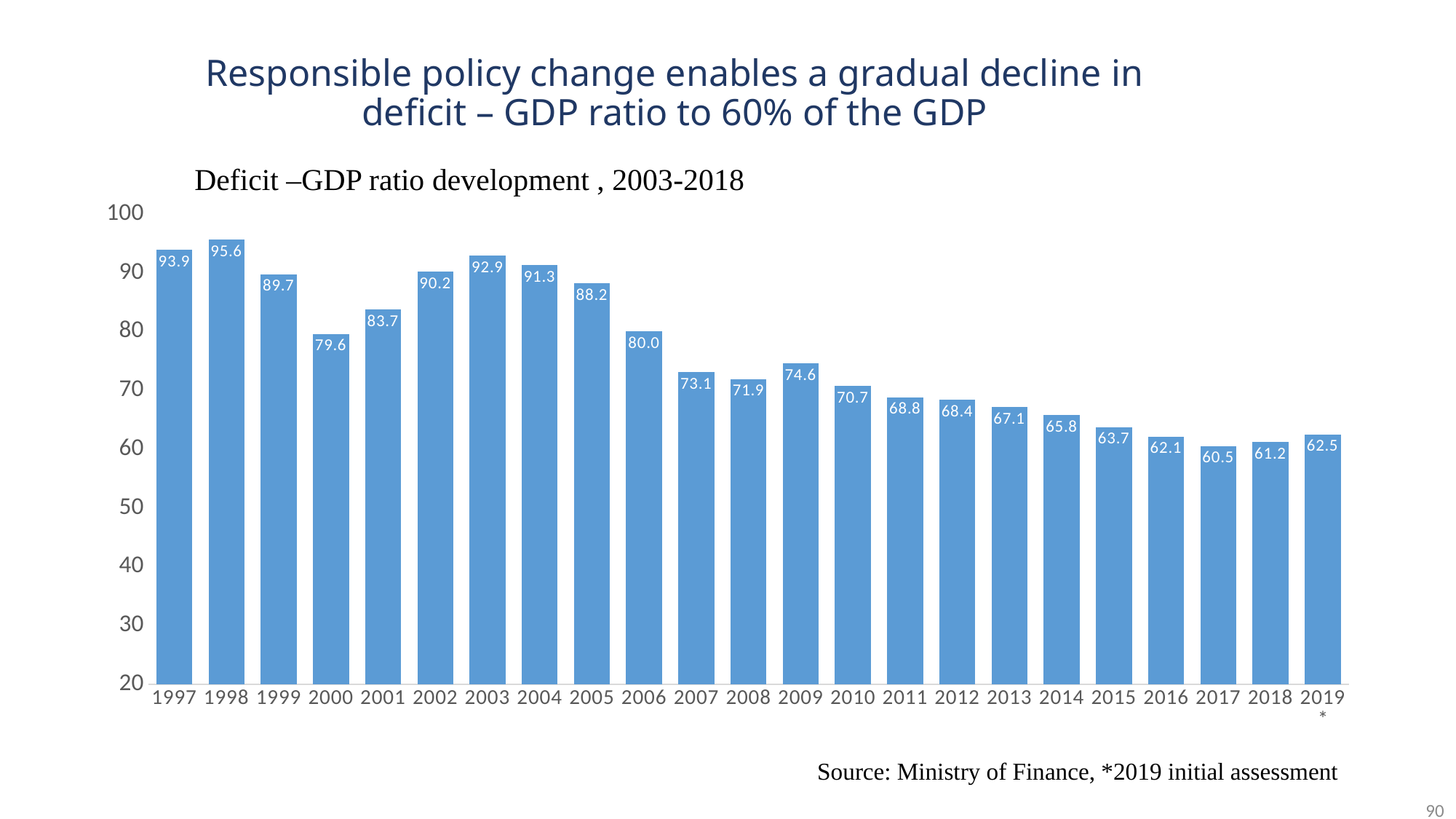
What is the value shown for 2017? 60.5 What is the difference between the values for 1998 and 2017? 35.1 Is the value for 2006 greater or less than 70? greater What kind of chart is shown on the slide? Bar chart What is the title of the chart? Deficit –GDP ratio development , 2003-2018 Which is larger, the value for 2009 or the value for 2008? 2009 Which year has the highest value in the chart? 1998 How many years are shown on the x axis of the chart? 23 Do the values generally rise or fall from 2005 to 2017? Fall What is the value shown for 2019*? 62.5 Which year has the lowest value in the chart? 2017 What is the deficit–GDP ratio value shown for 2003? 92.9